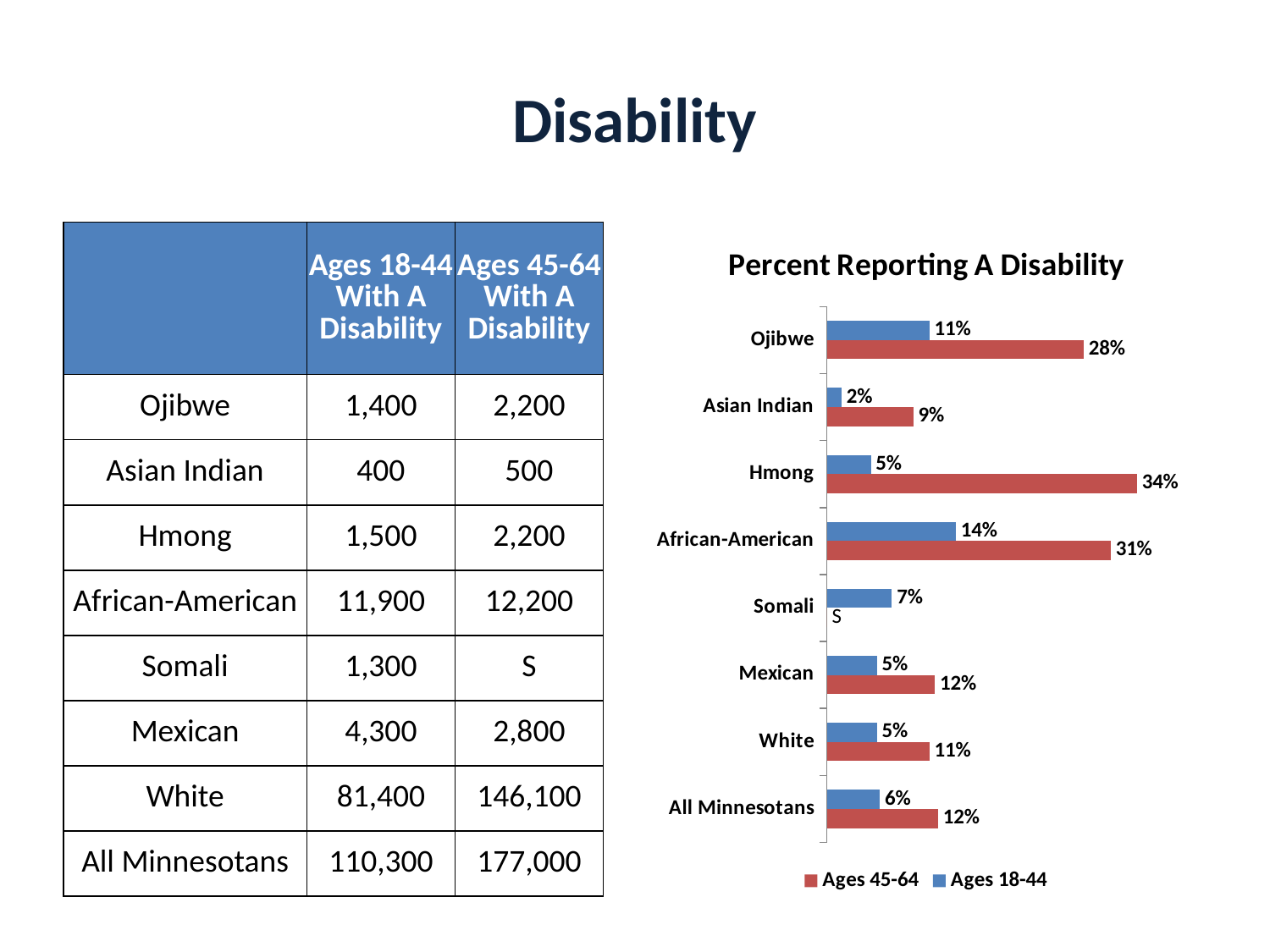
What is the value for Ojibwe in the Ages 45-64 series? 28% What is the value for Hmong in the Ages 45-64 series? 34% Which category has the lowest value in the Ages 18-44 series? Asian Indian What is the title of the chart? Percent Reporting A Disability How many categories are shown on the chart? 8 What kind of chart is shown on the slide? Bar chart Which is larger: the Ages 18-44 value for African-American or the Ages 18-44 value for Somali? African-American What is the value for African-American in the Ages 18-44 series? 14% What label is shown in place of a value for Somali in the Ages 45-64 series? S How many series does the legend list? 2 What is the difference between the Ages 45-64 and Ages 18-44 values for Ojibwe? 17% Which category has the highest value in the Ages 45-64 series? Hmong